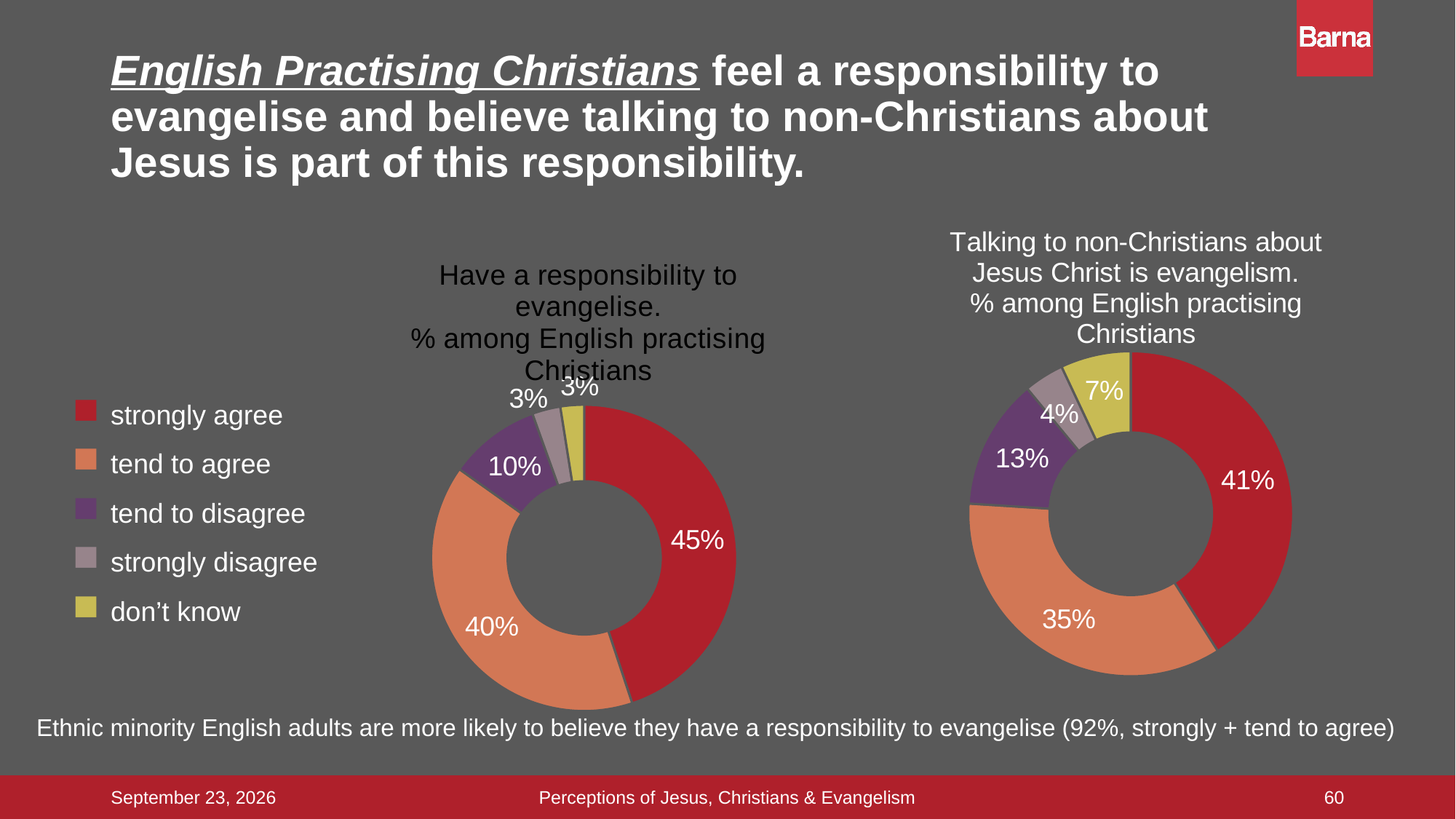
In the 'Have a responsibility to evangelise' chart, what percentage strongly agree? 45% What type of chart is the 'Have a responsibility to evangelise' chart? doughnut chart In the 'Have a responsibility to evangelise' chart, what is the difference between the strongly agree and tend to agree shares? 5 percentage points In the 'Have a responsibility to evangelise' chart, what percentage tend to disagree? 10% In the 'Have a responsibility to evangelise' chart, which response has the largest share? strongly agree In the 'Talking to non-Christians about Jesus Christ is evangelism' chart, which response has the largest share? strongly agree In the 'Talking to non-Christians about Jesus Christ is evangelism' chart, what is the difference between the tend to disagree and strongly disagree shares? 9 percentage points How many response categories does the legend list? 5 In the 'Talking to non-Christians about Jesus Christ is evangelism' chart, which response has the smallest share? strongly disagree Which chart has a larger share for tend to disagree: 'Have a responsibility to evangelise' or 'Talking to non-Christians about Jesus Christ is evangelism'? Talking to non-Christians about Jesus Christ is evangelism In the 'Talking to non-Christians about Jesus Christ is evangelism' chart, what percentage tend to agree? 35% In the 'Talking to non-Christians about Jesus Christ is evangelism' chart, what percentage answered don't know? 7%